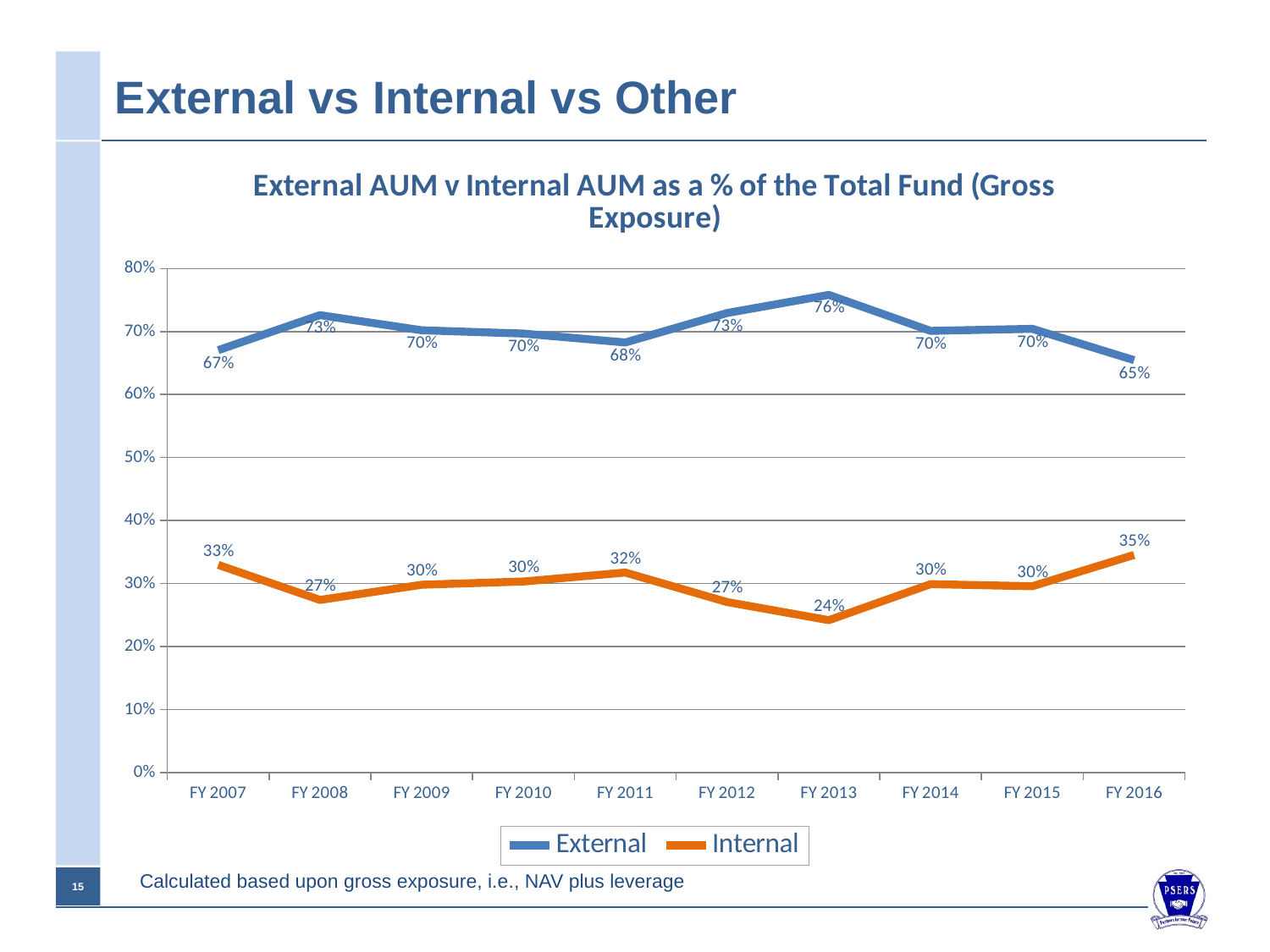
What kind of chart is shown on the slide? Line chart In which fiscal year is the Internal series lowest? FY 2013 How many series does the legend list? 2 What colour is the Internal line? Orange What is the difference between the External and Internal values in FY 2016? 30% How many fiscal years are shown on the x axis? 10 What is the Internal value for FY 2013? 24% Does the External series rise or fall from FY 2013 to FY 2016? Fall What is the External value for FY 2013? 76% In which fiscal year is the External series highest? FY 2013 What is the Internal value for FY 2016? 35% Which is larger in FY 2007, the External value or the Internal value? External